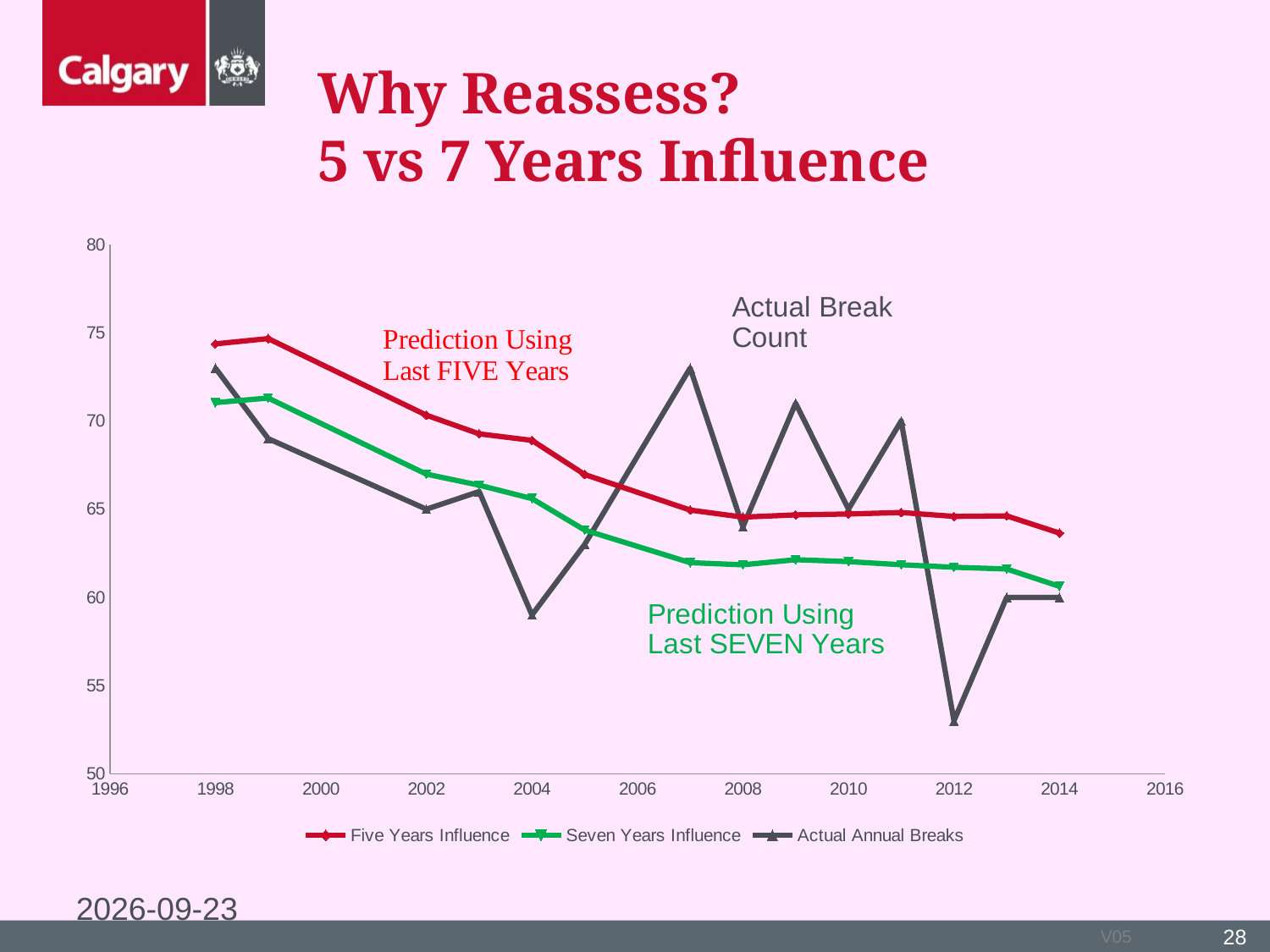
Does the Five Years Influence series generally rise or fall from 1998 to 2014? fall How many series does the legend list? 3 Is the value for Actual Annual Breaks in 2007 greater or less than 70? greater In 2012, which series has the higher value, Five Years Influence or Actual Annual Breaks? Five Years Influence Is the value for Seven Years Influence in 2014 greater or less than 65? less In which year is the Actual Annual Breaks series at its lowest? 2012 Is the value for Five Years Influence in 2014 greater or less than 60? greater What kind of chart is shown on the slide? line chart In 1998, which series has the higher value, Five Years Influence or Seven Years Influence? Five Years Influence Which series does the legend show with a red line? Five Years Influence